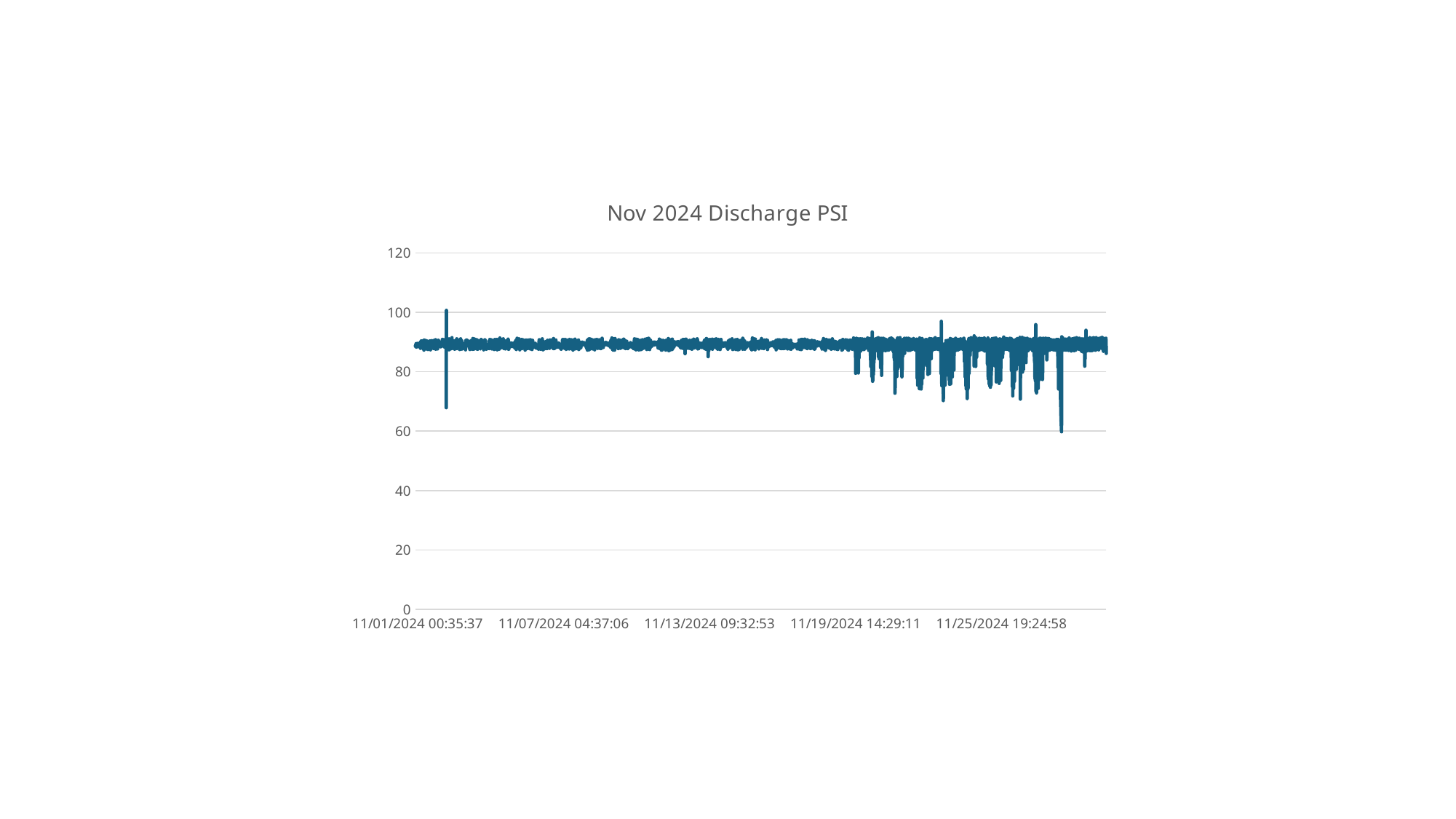
Is the lowest dip in the line, near the end of the month, greater or less than 40? greater Is the typical discharge PSI level across the month greater or less than 80? greater How many date labels are shown along the horizontal axis? 5 What is the title of the chart? Nov 2024 Discharge PSI What kind of chart is shown on the slide? line chart In which part of the month do the large downward dips in the line occur: the first half or the second half? second half Is the lowest dip in the line, near the end of the month, greater or less than 80? less What is the highest value shown on the vertical axis? 120 Does the line generally rise, fall, or stay roughly flat across the month? roughly flat What is the last date label on the horizontal axis? 11/25/2024 19:24:58 What is the first date label on the horizontal axis? 11/01/2024 00:35:37